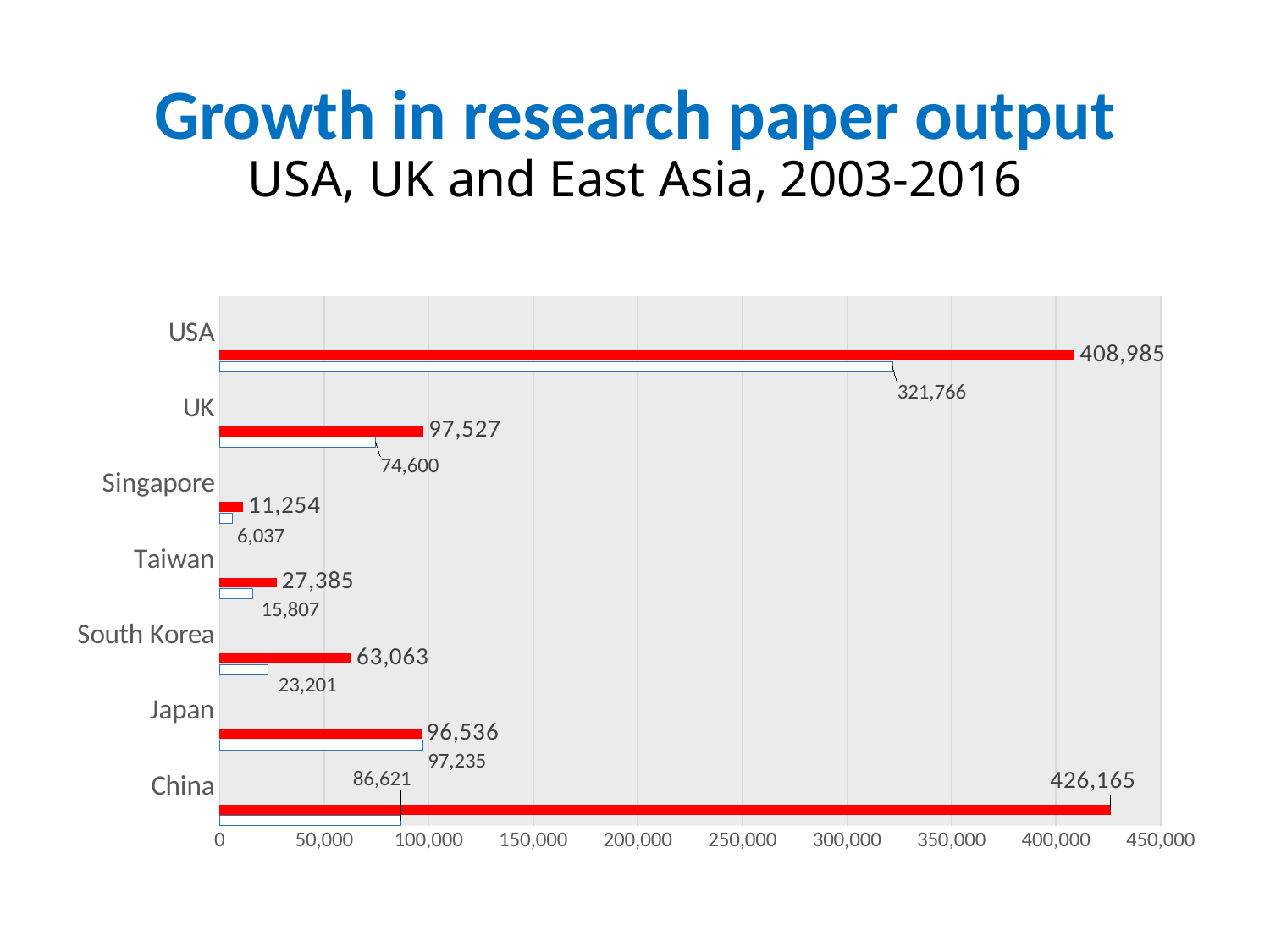
Which is larger for Japan, the red bar or the white bar? the white bar Which country has the highest red bar value? China What is the value of the white bar for USA? 321,766 What kind of chart is shown on the slide? bar chart What is the difference between the red bar values for China and USA? 17,180 What is the value of the white bar for South Korea? 23,201 What is the difference between the red bar and the white bar for the UK? 22,927 What is the value of the red bar for China? 426,165 What is the value of the red bar for Singapore? 11,254 What is the title of the chart on the slide? Growth in research paper output How many countries are shown on the chart? 7 Which country has the lowest white bar value? Singapore